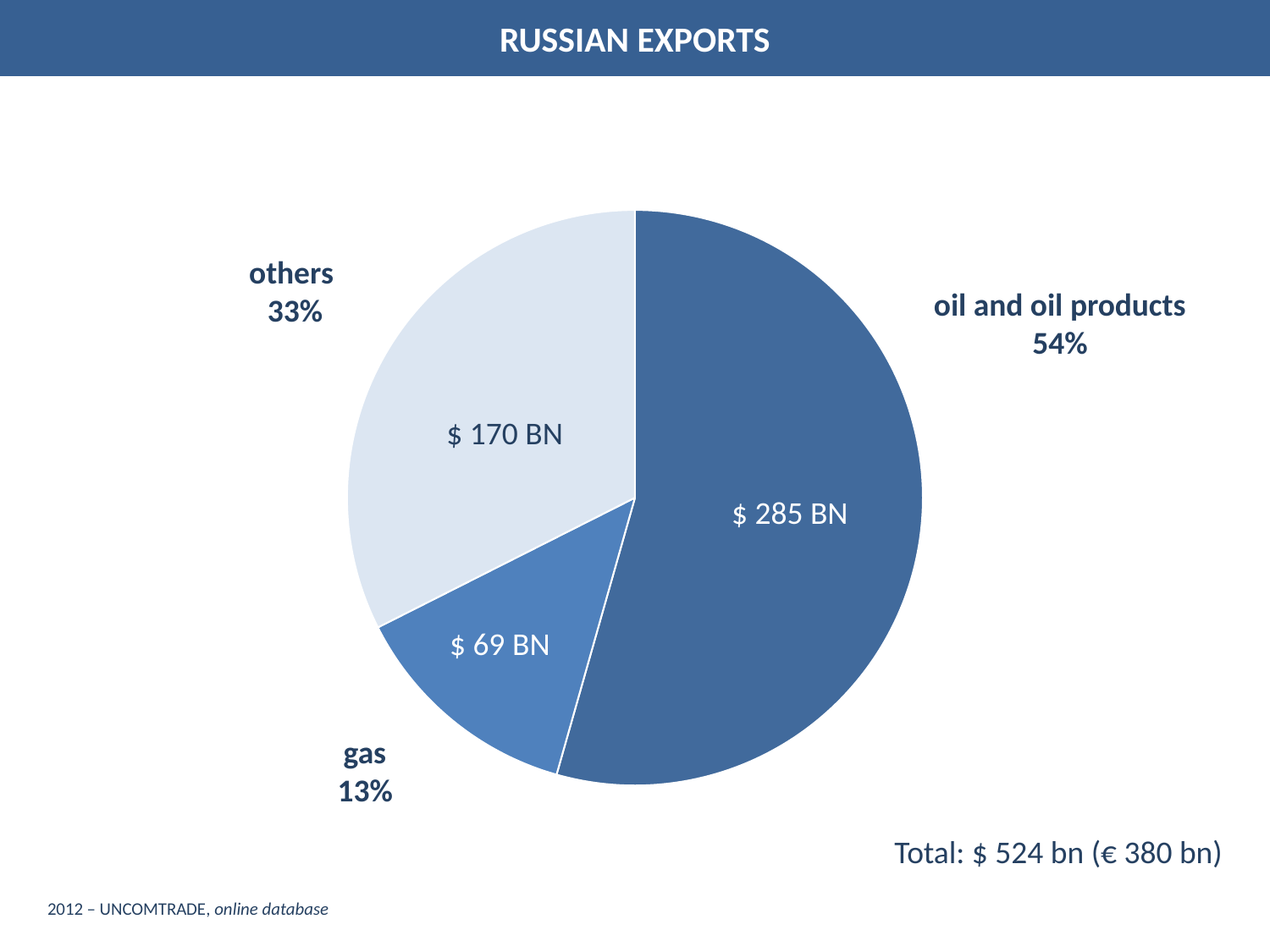
How many slices does the pie chart have? 3 What share of the pie does others represent? 33% Which category has the smallest slice? gas What is the value for oil and oil products? $ 285 BN Which is larger, the value for others or the value for gas? others Which category has the largest slice? oil and oil products What share of the pie does oil and oil products represent? 54% What type of chart is shown on the slide? pie chart What is the difference in value between oil and oil products and others? $ 115 BN What share of the pie does gas represent? 13% What is the value for gas? $ 69 BN What is the value for others? $ 170 BN